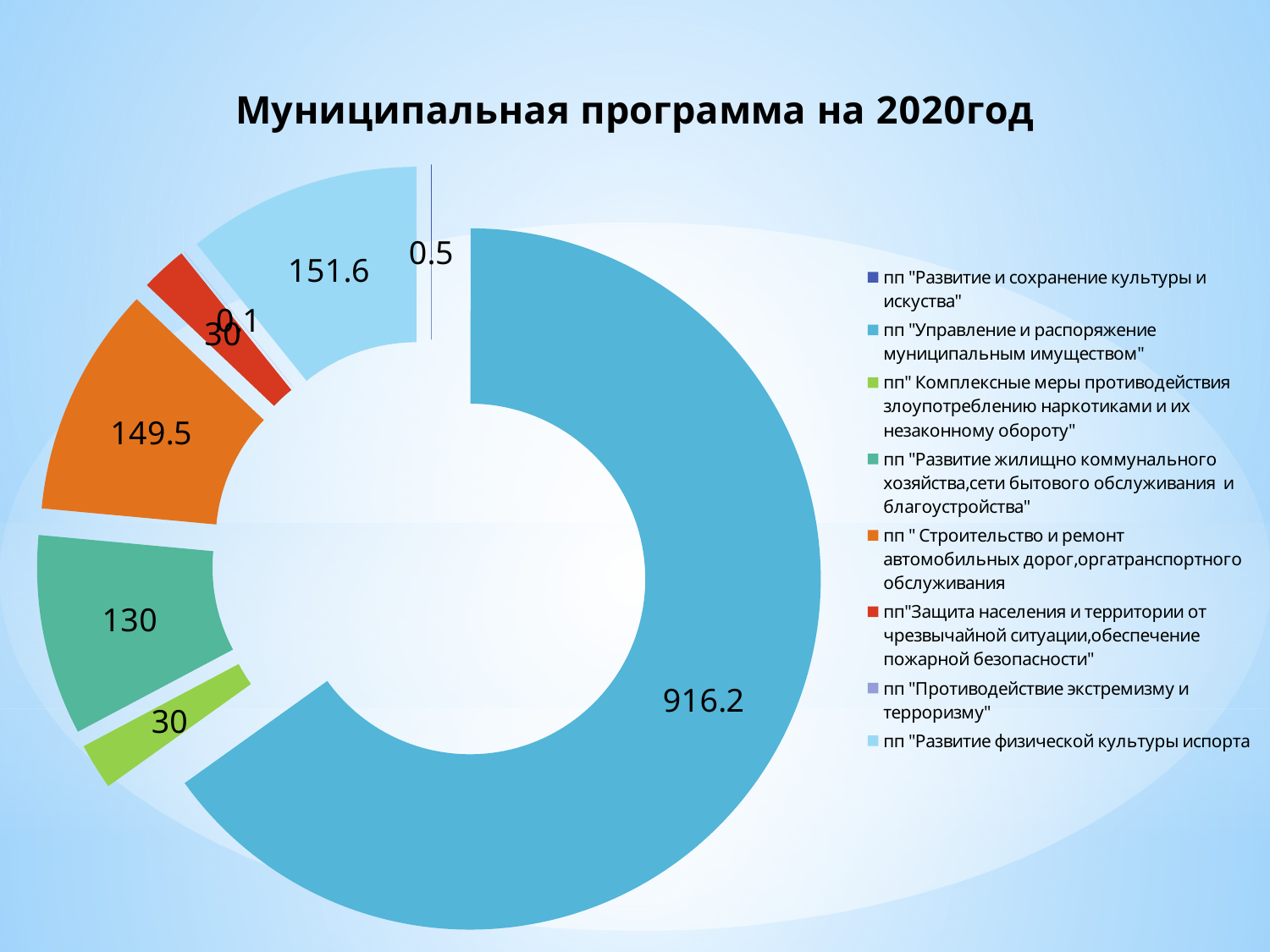
What is the value for пп "Развитие физической культуры и спорта"? 151.6 Which category has the smallest value? пп "Противодействие экстремизму и терроризму" What is the value for пп "Строительство и ремонт автомобильных дорог, оргатранспортного обслуживания"? 149.5 What is the title of the chart? Муниципальная программа на 2020год Which category has the largest value? пп "Управление и распоряжение муниципальным имуществом" What is the value for пп "Противодействие экстремизму и терроризму"? 0.1 What is the value for пп "Управление и распоряжение муниципальным имуществом"? 916.2 Which is larger: the value for пп "Развитие жилищно коммунального хозяйства" or the value for пп "Защита населения и территории от чрезвычайной ситуации"? пп "Развитие жилищно коммунального хозяйства" What is the value for пп "Развитие жилищно коммунального хозяйства, сети бытового обслуживания и благоустройства"? 130 How many categories does the chart contain? 8 What is the difference between the values for пп "Развитие физической культуры и спорта" and пп "Строительство и ремонт автомобильных дорог"? 2.1 What kind of chart is shown on the slide? Doughnut (pie) chart